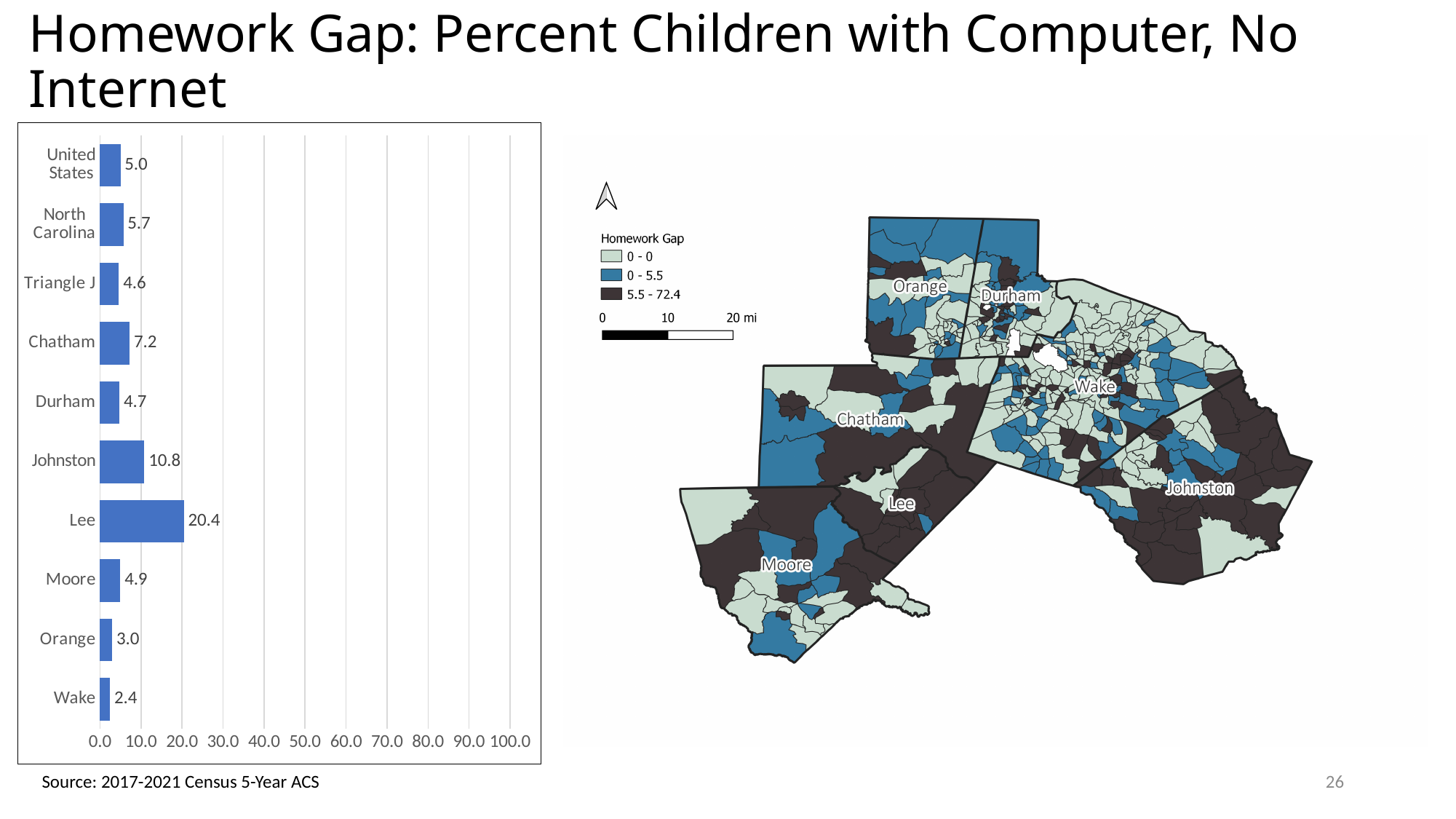
In the bar chart, which category has the lowest value? Wake In the bar chart, what is the difference between the values for Lee and Johnston? 9.6 In the bar chart, is the value for Lee greater or less than 20.0? greater How many categories are shown in the bar chart? 10 In the bar chart, what is the value for North Carolina? 5.7 In the bar chart, what is the value for Johnston? 10.8 In the bar chart, what is the value for Wake? 2.4 In the bar chart, which is larger, the value for Chatham or the value for Durham? Chatham In the bar chart, which category has the highest value? Lee In the bar chart, what is the value for Lee? 20.4 What kind of chart is on the left side of the slide? bar chart How many classes does the map legend titled 'Homework Gap' list? 3